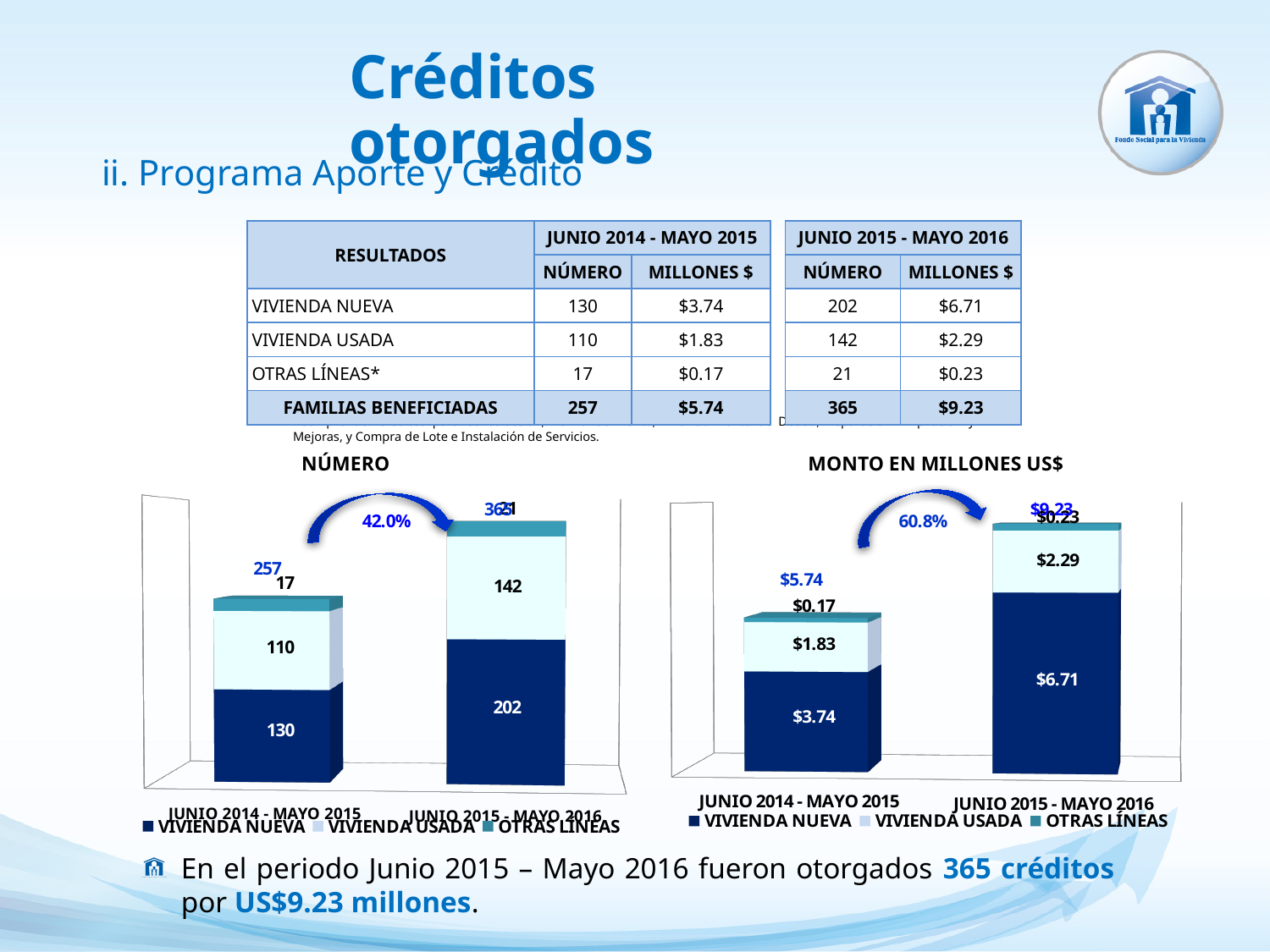
In the NÚMERO chart, what is the value for VIVIENDA NUEVA in JUNIO 2015 - MAYO 2016? 202 In the MONTO EN MILLONES US$ chart, what is the value for OTRAS LÍNEAS in JUNIO 2014 - MAYO 2015? $0.17 In the MONTO EN MILLONES US$ chart, what is the total of the stacked bar for JUNIO 2014 - MAYO 2015? $5.74 In the NÚMERO chart, what is the difference between VIVIENDA NUEVA in JUNIO 2015 - MAYO 2016 and VIVIENDA NUEVA in JUNIO 2014 - MAYO 2015? 72 In the NÚMERO chart, which series has the lowest value in JUNIO 2014 - MAYO 2015? OTRAS LÍNEAS In the NÚMERO chart, what is the total of the stacked bar for JUNIO 2015 - MAYO 2016? 365 What percentage increase is shown by the arrow on the MONTO EN MILLONES US$ chart? 60.8% In the MONTO EN MILLONES US$ chart, which period has the larger value for VIVIENDA USADA? JUNIO 2015 - MAYO 2016 In the MONTO EN MILLONES US$ chart, what is the value for VIVIENDA NUEVA in JUNIO 2015 - MAYO 2016? $6.71 What kind of chart is the NÚMERO chart? Stacked bar chart How many series does the legend of the MONTO EN MILLONES US$ chart list? 3 In the NÚMERO chart, what is the value for VIVIENDA USADA in JUNIO 2014 - MAYO 2015? 110